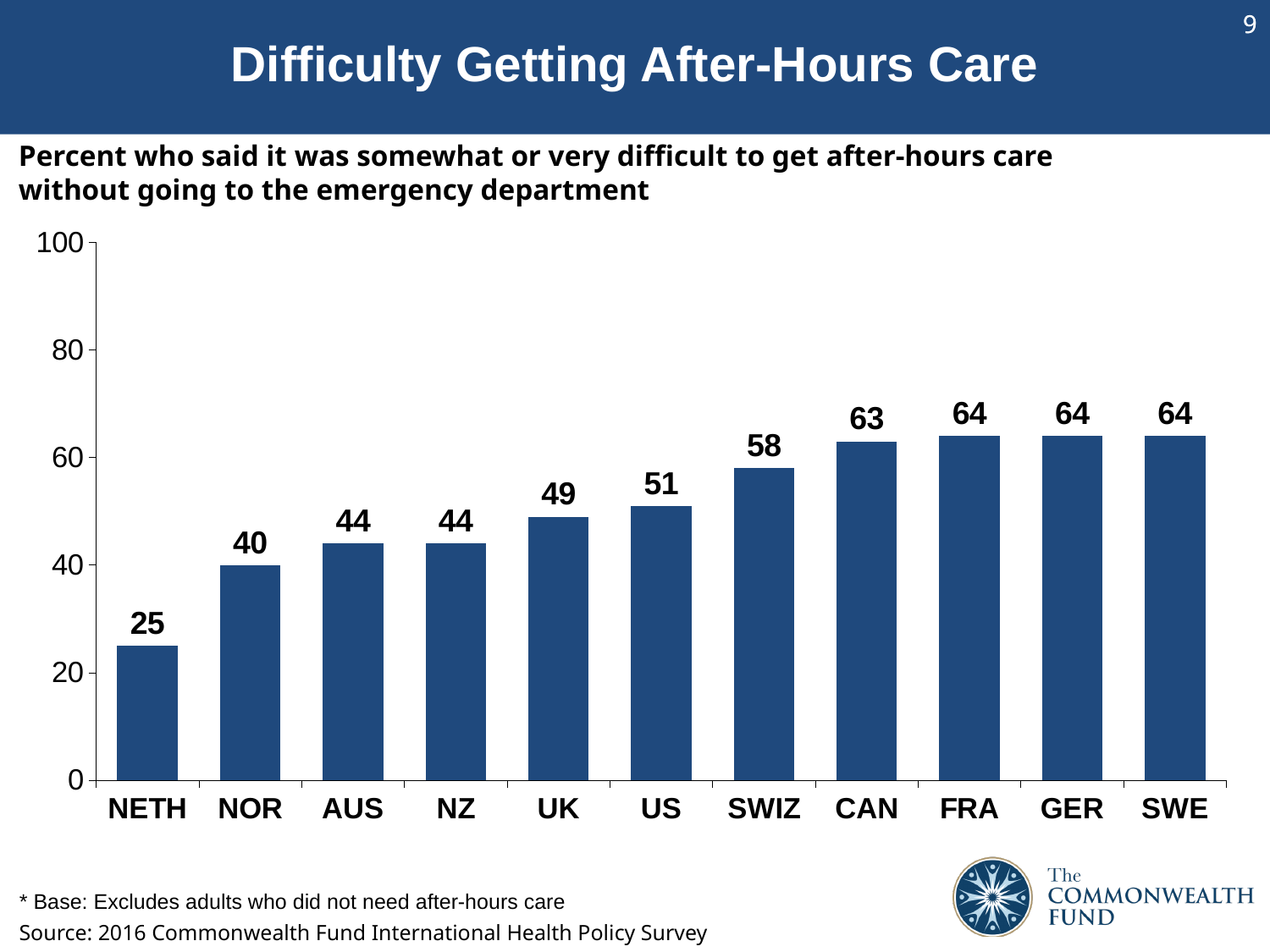
What is the value for SWIZ? 58 What is the value for US? 51 Do the values rise or fall from left to right along the x axis? rise Which country has the lowest value? NETH What kind of chart is shown on the slide? bar chart What is the title of the slide? Difficulty Getting After-Hours Care How many countries are shown on the x axis? 11 What is the difference between the values for UK and NETH? 24 What is the value for NETH? 25 What is the difference between the values for CAN and NOR? 23 Is the value for NOR greater or less than 60? less Which is larger, the value for SWIZ or the value for US? SWIZ